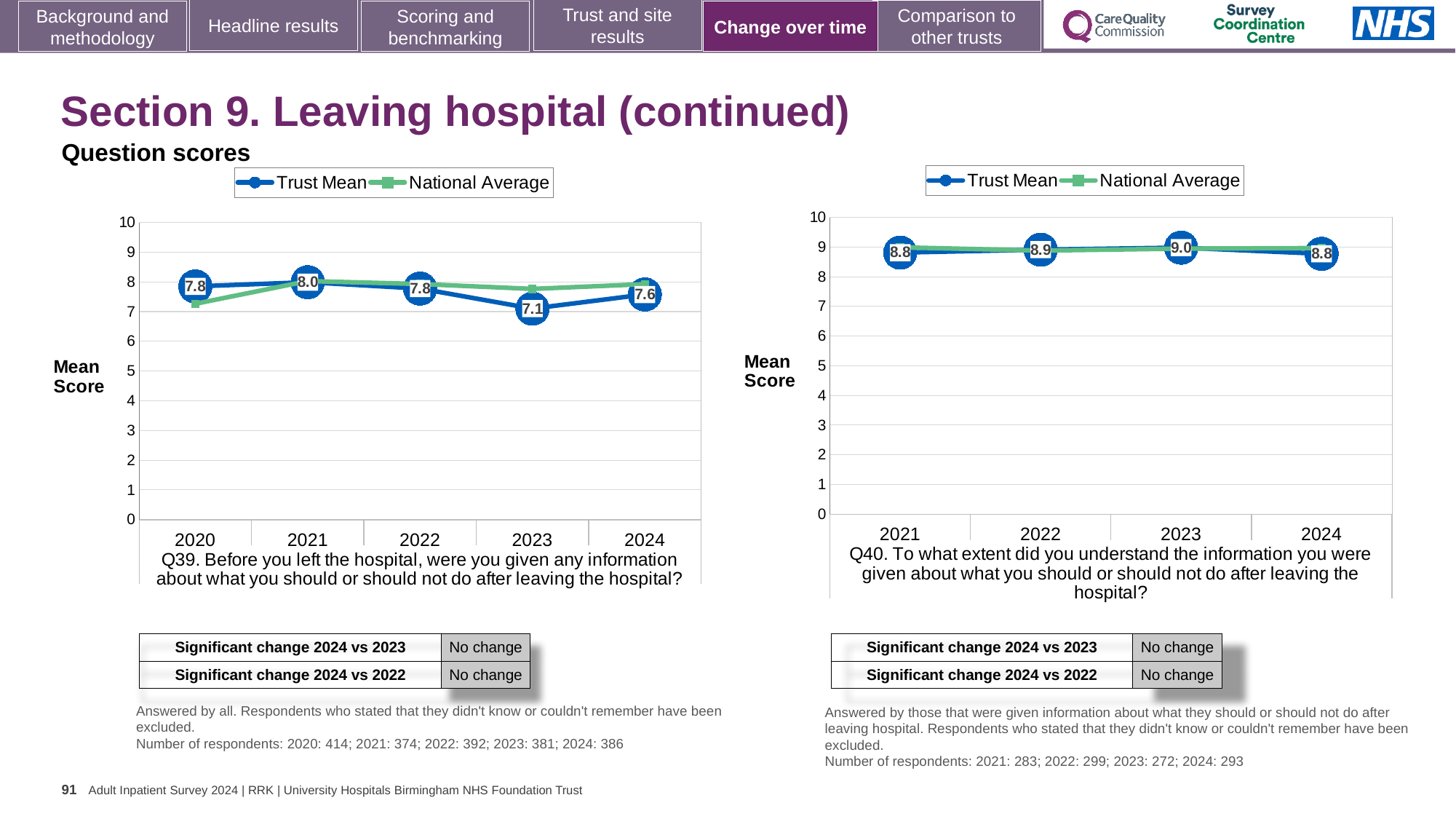
In the Q39 chart (left), which year has the lowest Trust Mean score? 2023 In the Q40 chart (right), which year has the highest Trust Mean score? 2023 What type of chart is the Q40 chart (right)? Line chart In the Q39 chart (left), how many years are plotted on the x axis? 5 In the Q39 chart (left), what is the Trust Mean score for 2023? 7.1 In the Q39 chart (left), which year has the highest Trust Mean score? 2021 In the Q40 chart (right), is the Trust Mean score for 2022 larger or smaller than the score for 2024? larger In the Q40 chart (right), what is the Trust Mean score for 2023? 9.0 In the Q39 chart (left), is the National Average for 2020 greater or less than 8? less In the Q39 chart (left), what is the Trust Mean score for 2021? 8.0 In the Q39 chart (left), what is the difference between the Trust Mean scores for 2021 and 2023? 0.9 How many series does the legend of the Q40 chart (right) list? 2